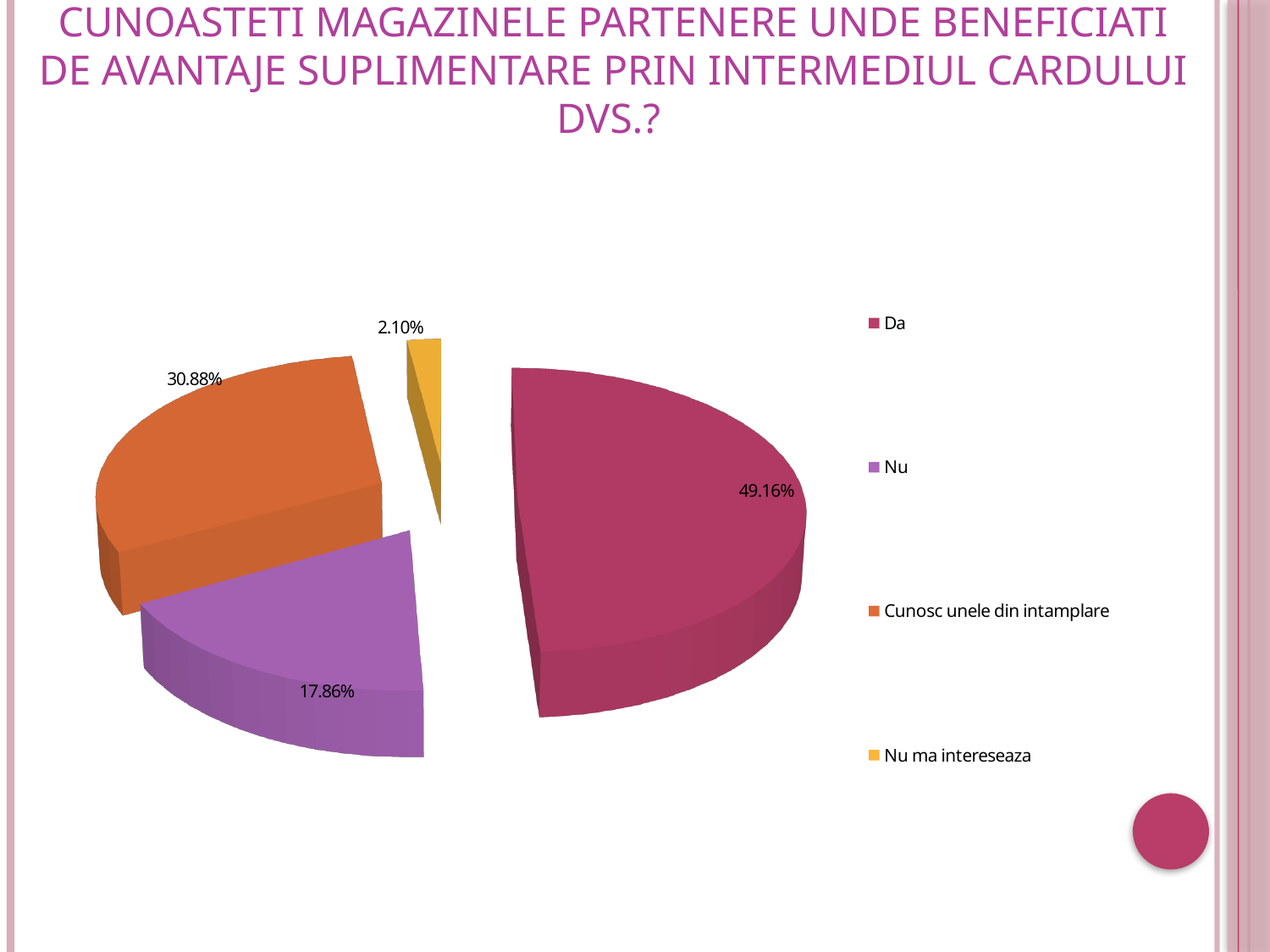
What share of the pie does the "Da" slice represent? 49.16% What share of the pie does the "Nu" slice represent? 17.86% Which is larger, the slice for "Nu" or the slice for "Cunosc unele din intamplare"? Cunosc unele din intamplare What is the difference in percentage points between the "Da" slice and the "Cunosc unele din intamplare" slice? 18.28 How many categories does the pie chart have? 4 What is the difference in percentage points between the "Nu" slice and the "Nu ma intereseaza" slice? 15.76 What colour is the "Da" slice in the pie chart? magenta What share of the pie does the "Nu ma intereseaza" slice represent? 2.10% What kind of chart is shown on the slide? pie chart Which category has the smallest slice of the pie? Nu ma intereseaza Which category has the largest slice of the pie? Da